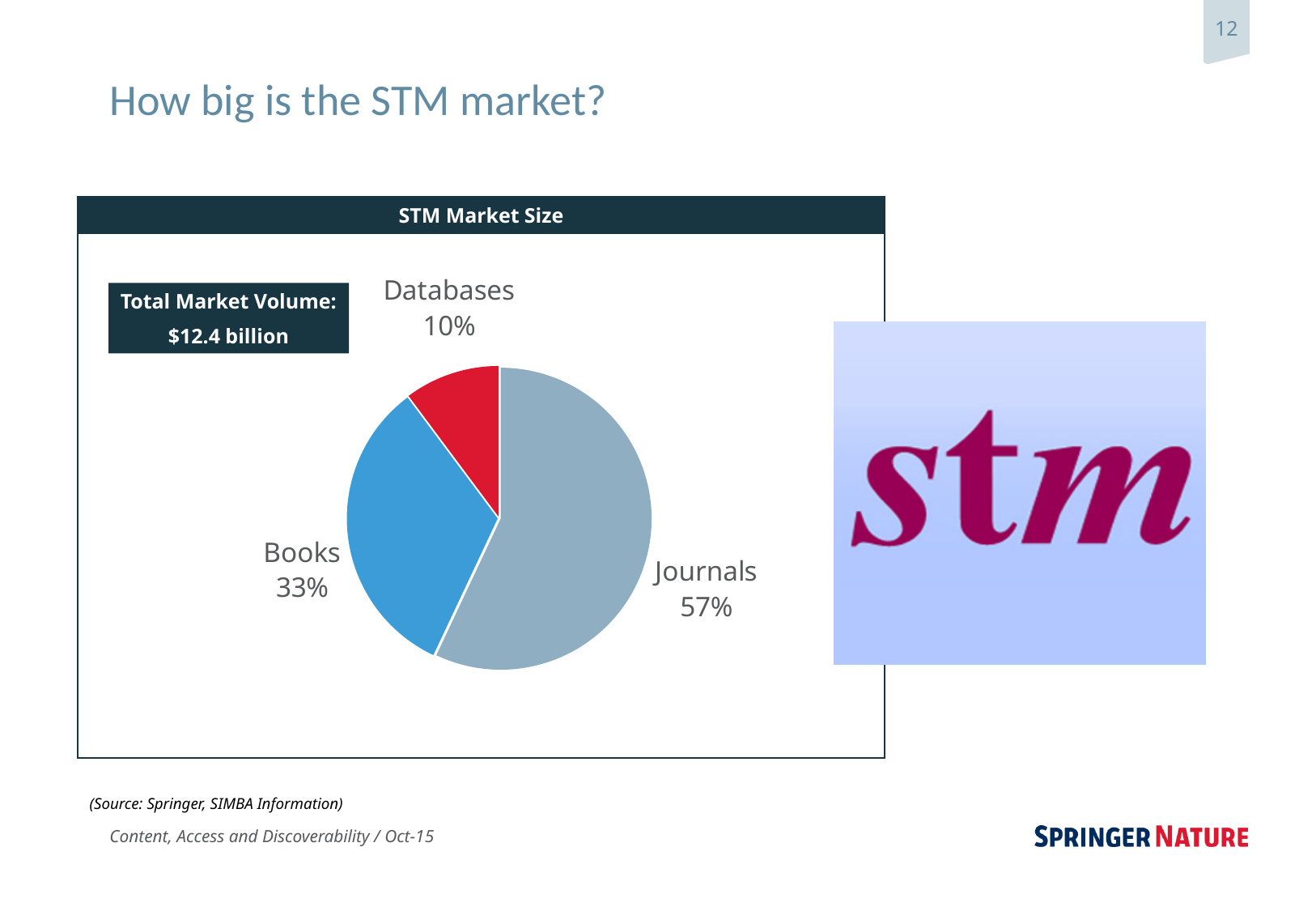
What share of the STM market do Databases account for? 10% What share of the STM market do Journals account for? 57% What is the title of the chart? STM Market Size Which is larger, the share for Books or the share for Databases? Books Which segment has the largest share of the STM market? Journals What is the combined share of Books and Databases? 43% How many segments does the pie chart have? 3 What is the difference in percentage points between the Journals share and the Books share? 24 percentage points What total market volume is stated on the chart? $12.4 billion Which segment has the smallest share of the STM market? Databases What kind of chart is shown on the slide? pie chart What share of the STM market do Books account for? 33%